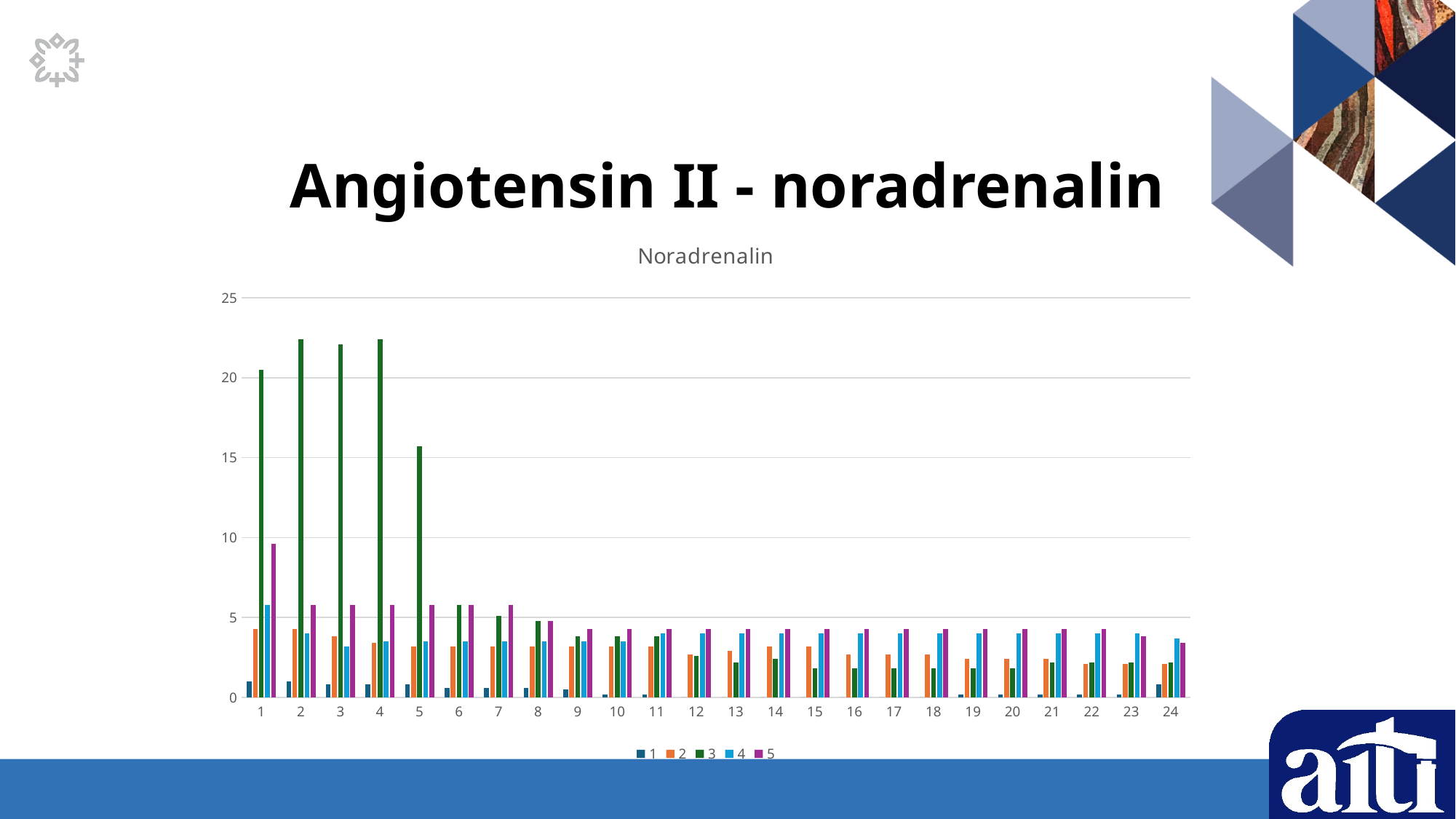
Is the value for series 3 at category 2 greater or less than 20? greater Do the values for series 3 rise or fall overall from category 1 to category 24? fall Is the value for series 3 at category 5 greater or less than 15? greater How many series does the legend list? 5 Which series has the highest value at category 3? 3 Is the value for series 3 at category 6 greater or less than 5? greater Which series has the lowest value at category 2? 1 What kind of chart is shown on the slide? bar chart How many categories are shown along the x axis? 24 What is the title of the chart? Noradrenalin